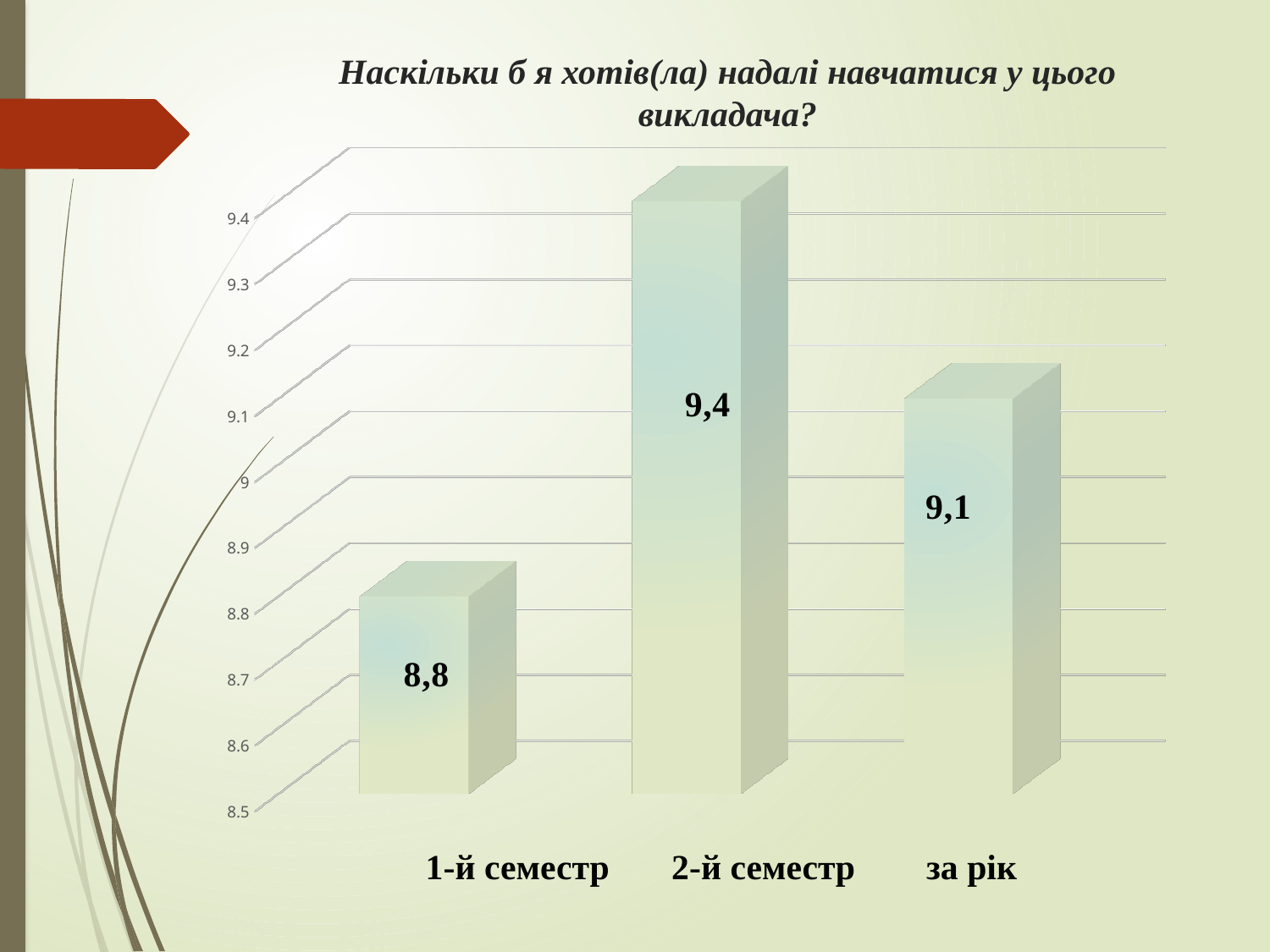
What is the value for 2-й семестр? 9,4 What is the value for 1-й семестр? 8,8 What kind of chart is shown on the slide? bar chart Which category has the lowest value? 1-й семестр Which category has the highest value? 2-й семестр Is the value for 1-й семестр greater or less than 9? less What is the value for за рік? 9,1 How many categories are shown on the chart? 3 What is the difference between the values for 2-й семестр and 1-й семестр? 0,6 What is the title of the chart? Наскільки б я хотів(ла) надалі навчатися у цього викладача? What is the difference between the values for за рік and 1-й семестр? 0,3 Which is larger, the value for за рік or the value for 1-й семестр? за рік